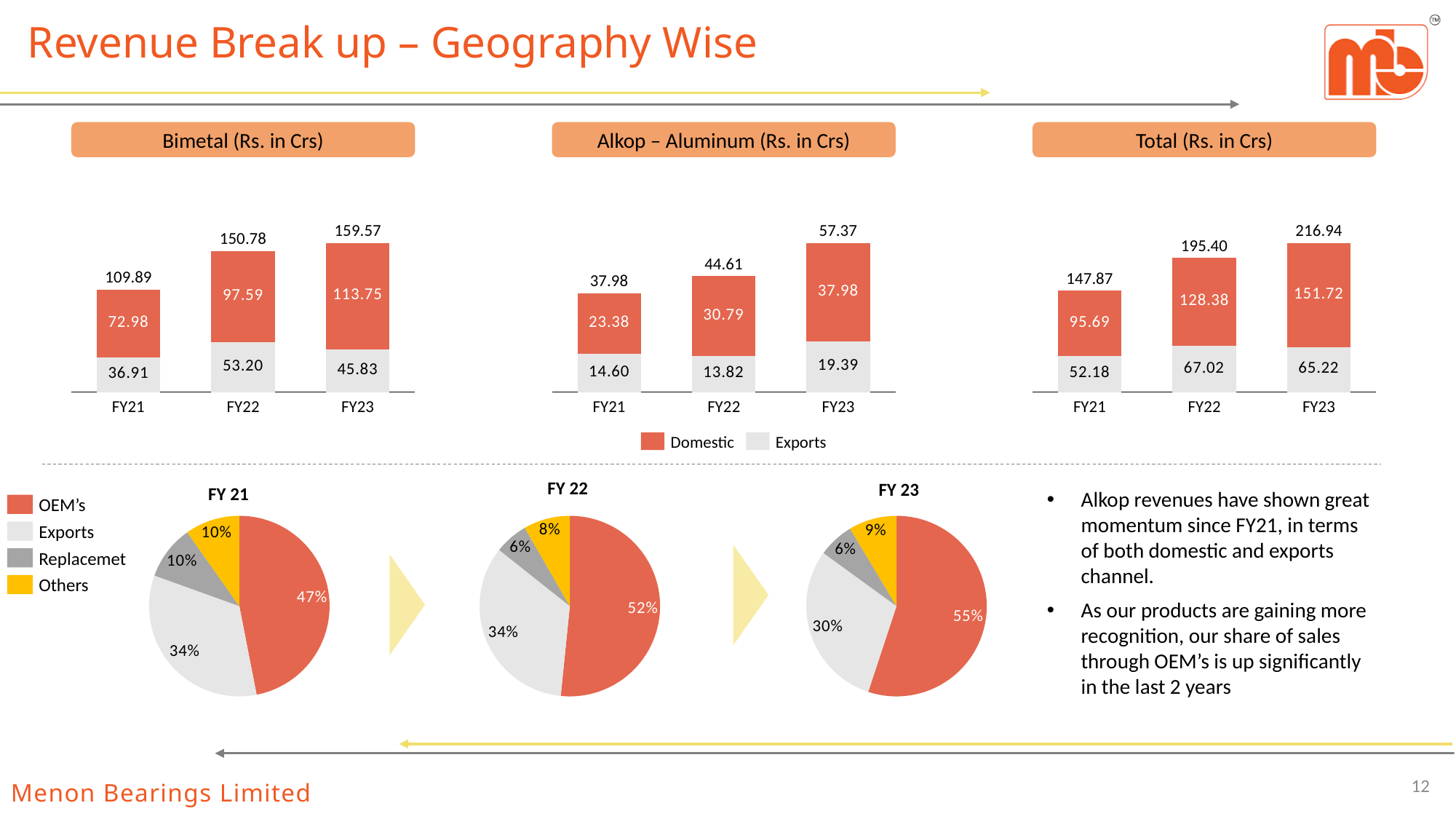
How many series does the legend for the bar charts list? 2 In the Total (Rs. in Crs) chart, what is the total of the stacked bar for FY22? 195.40 In the Total (Rs. in Crs) chart, which year has the highest total revenue? FY23 In the Alkop – Aluminum (Rs. in Crs) chart, what is the Exports value for FY23? 19.39 In the Total (Rs. in Crs) chart, do the Domestic values rise or fall from FY21 to FY23? rise In the FY 23 pie chart, what share does OEM's have? 55% In the FY 21 pie chart, what is the value for Replacemet? 10% In the Alkop – Aluminum (Rs. in Crs) chart, which year has the lowest Exports value? FY22 In the Bimetal (Rs. in Crs) chart, what is the Domestic value for FY22? 97.59 In the Bimetal (Rs. in Crs) chart, what is the difference between the Domestic value for FY23 and the Domestic value for FY21? 40.77 What kind of chart is the Bimetal (Rs. in Crs) chart? stacked bar chart In the Alkop – Aluminum (Rs. in Crs) chart, is the Exports value larger in FY21 or FY22? FY21